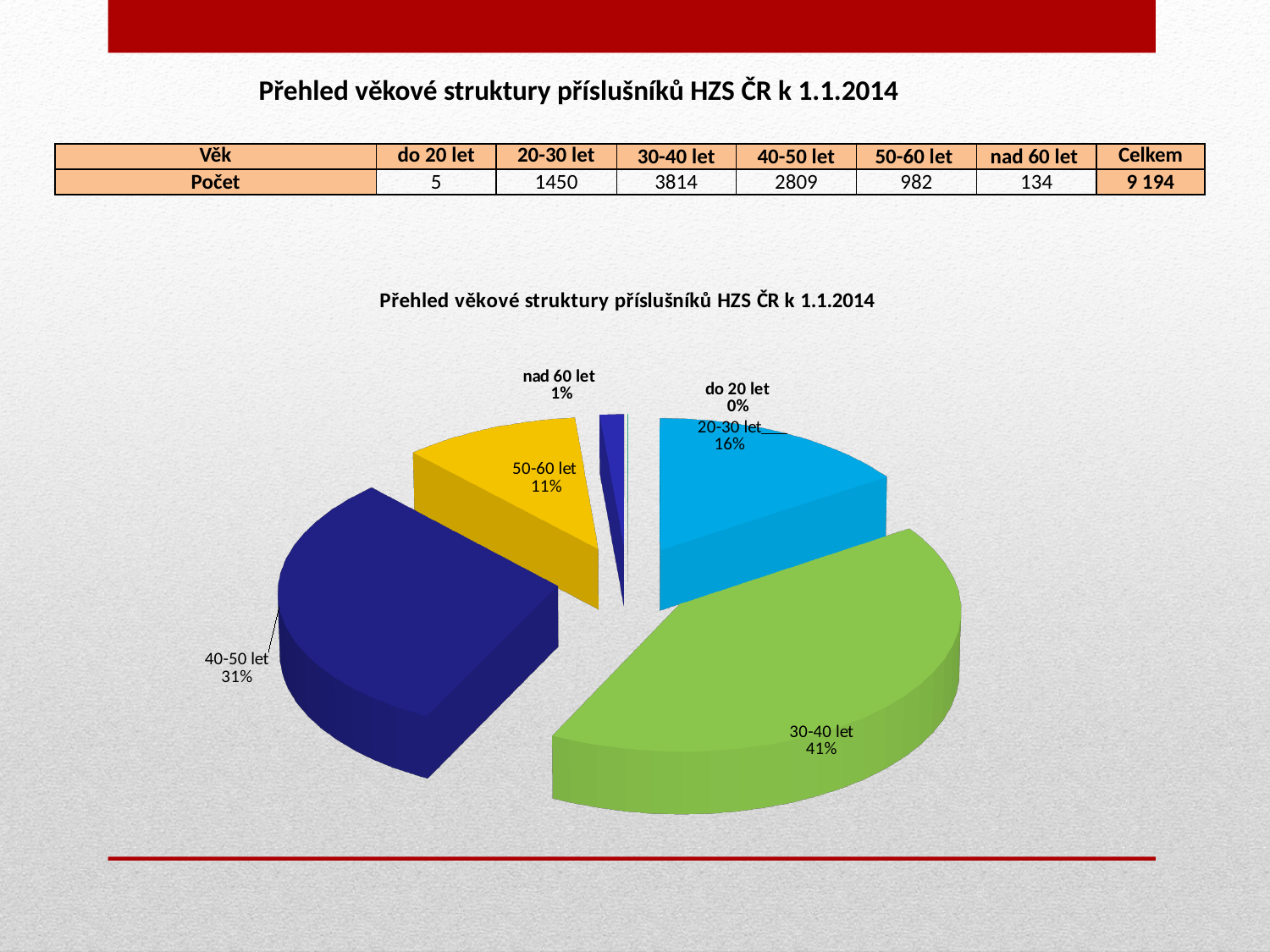
What is the title of the pie chart? Přehled věkové struktury příslušníků HZS ČR k 1.1.2014 Which slice is larger, 20-30 let or 50-60 let? 20-30 let By how many percentage points does the 30-40 let share exceed the 40-50 let share? 10 What kind of chart is shown on the slide? Pie chart What share of the pie does the 50-60 let slice represent? 11% What share of the pie does the 20-30 let slice represent? 16% What share of the pie does the nad 60 let slice represent? 1% Which age group has the largest slice in the pie chart? 30-40 let Which age group has the smallest slice in the pie chart? do 20 let How many slices does the pie chart have? 6